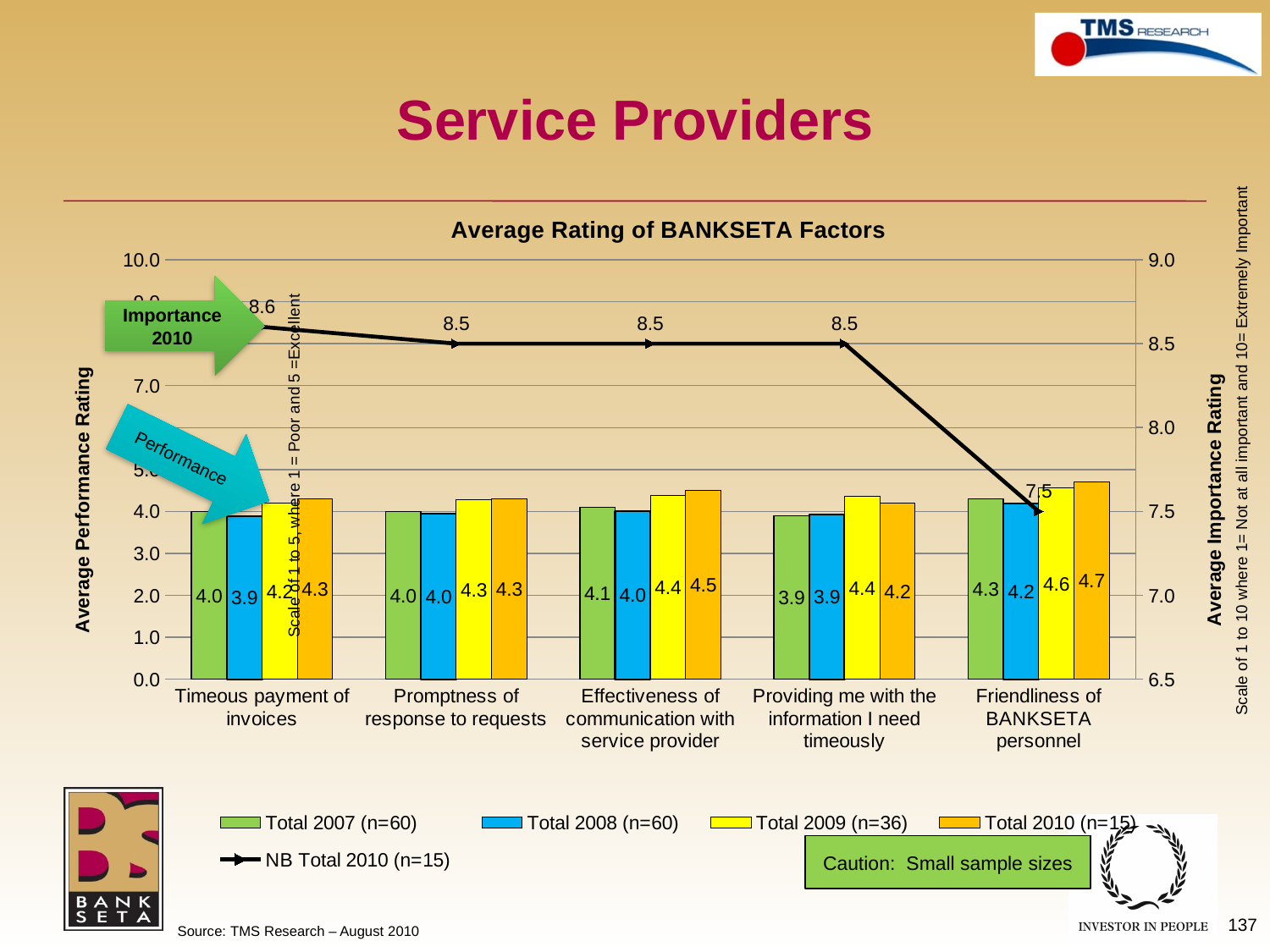
What is the Total 2010 (n=15) value for Friendliness of BANKSETA personnel? 4.7 How many series does the legend list? 5 What is the title of the chart? Average Rating of BANKSETA Factors What kind of chart is used to show the Total 2007 to Total 2010 performance ratings? Bar chart Which category has the lowest NB Total 2010 (n=15) importance value? Friendliness of BANKSETA personnel Which is larger for Promptness of response to requests: the Total 2009 (n=36) value or the Total 2007 (n=60) value? Total 2009 (n=36) Which category has the highest Total 2010 (n=15) performance rating? Friendliness of BANKSETA personnel What is the Total 2007 (n=60) value for Effectiveness of communication with service provider? 4.1 How many categories are shown on the x axis? 5 What is the NB Total 2010 (n=15) importance value for Timeous payment of invoices? 8.6 What is the NB Total 2010 (n=15) importance value for Friendliness of BANKSETA personnel? 7.5 What is the difference between the Total 2009 (n=36) and Total 2008 (n=60) values for Providing me with the information I need timeously? 0.5